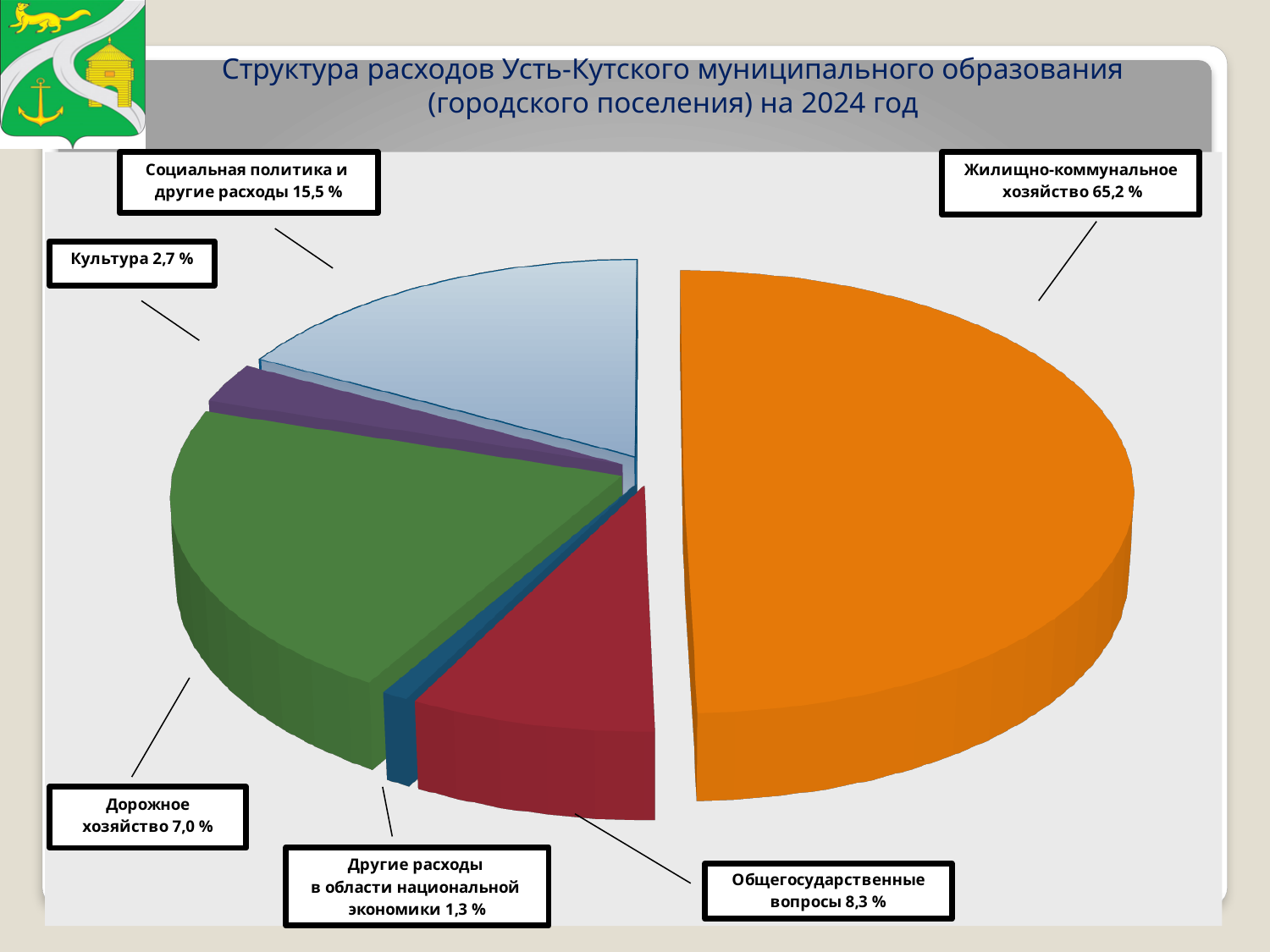
What share of expenditures goes to Социальная политика и другие расходы? 15,5 % What share of expenditures goes to Культура? 2,7 % What share of expenditures goes to Жилищно-коммунальное хозяйство? 65,2 % What share of expenditures goes to Другие расходы в области национальной экономики? 1,3 % What is the difference in percentage points between Жилищно-коммунальное хозяйство and Социальная политика и другие расходы? 49,7 How many categories (slices) does the pie chart have? 6 What kind of chart is shown on the slide? Pie chart Which category has the largest share of expenditures? Жилищно-коммунальное хозяйство What share of expenditures goes to Общегосударственные вопросы? 8,3 % Which category has the smallest share of expenditures? Другие расходы в области национальной экономики What share of expenditures goes to Дорожное хозяйство? 7,0 % Which category is represented by the orange slice? Жилищно-коммунальное хозяйство